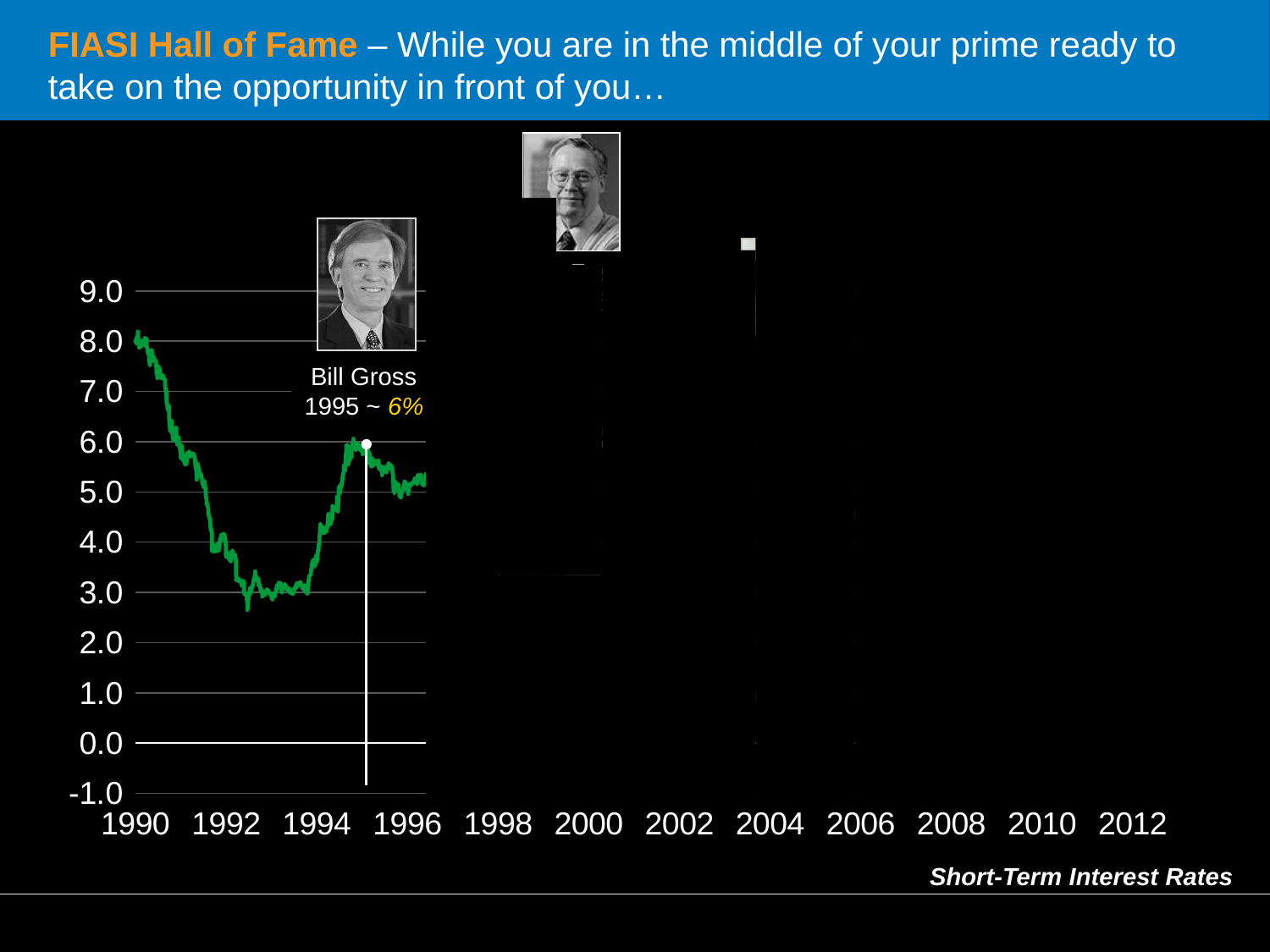
Is the short-term interest rate in 1993 greater or less than 4.0? less What rate does the annotation give for Bill Gross in 1995? 6% Is the short-term interest rate at the start of 1990 greater or less than 7.0? greater What label appears at the bottom right of the chart describing the data? Short-Term Interest Rates Which is higher, the short-term interest rate in 1990 or in 1995? 1990 Which is higher, the short-term interest rate in 1993 or in 1995? 1995 Is the short-term interest rate in 1995 greater or less than 5.0? greater Whose name is given in the annotation on the chart? Bill Gross What kind of chart is shown on the slide? line chart Does the short-term interest rate rise or fall from 1990 to 1992? fall Does the short-term interest rate rise or fall from 1993 to 1995? rise How many data series are plotted on the chart? 1